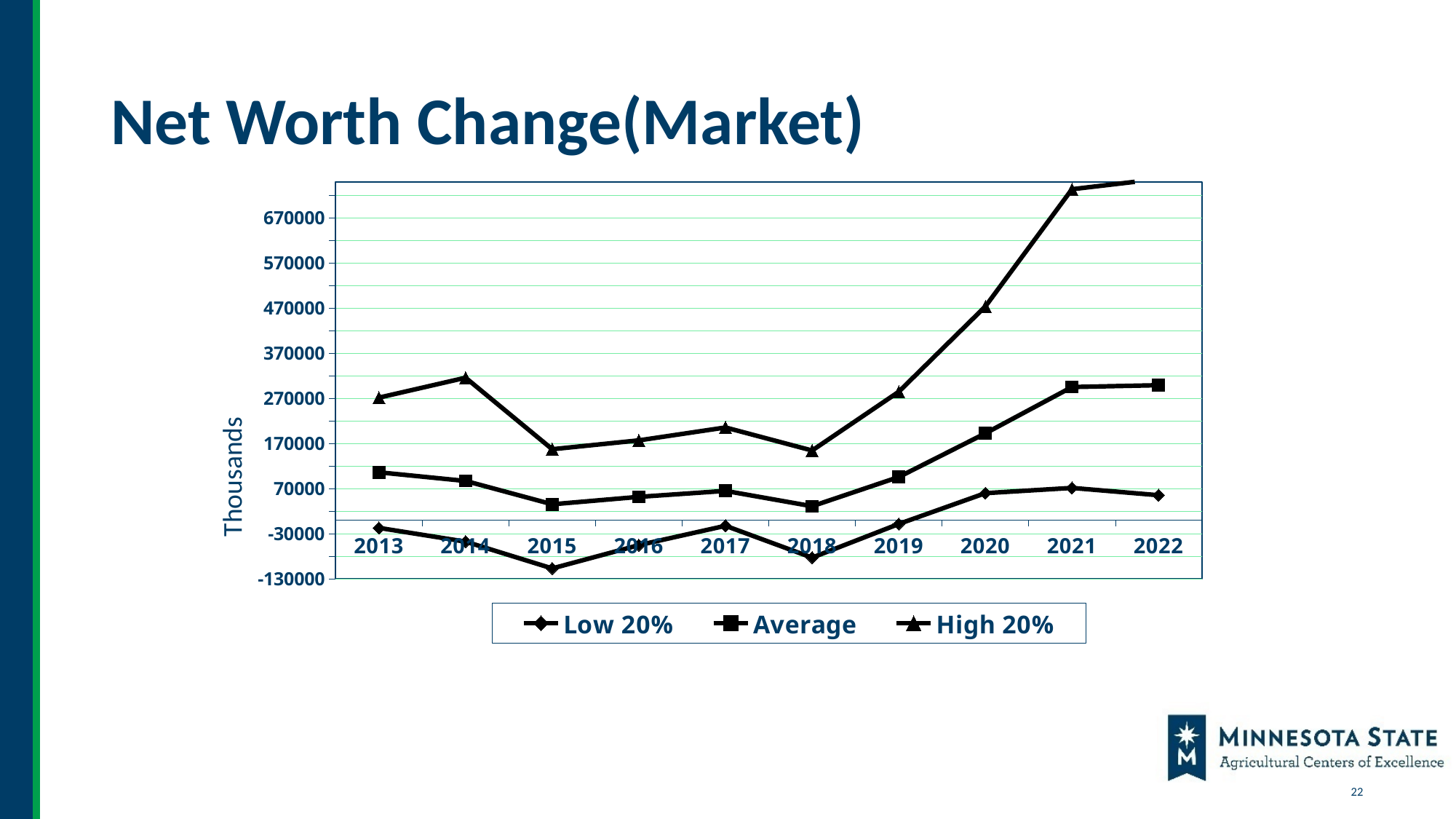
What kind of chart is shown on the slide? Line chart Which is larger for the Average series: the value in 2013 or the value in 2021? 2021 What is the label on the vertical axis? Thousands How many years are plotted along the x axis? 10 Is the value for Low 20% in 2015 greater or less than -30000? less Does the High 20% series rise or fall from 2018 to 2022? Rises Is the value for Average in 2018 greater or less than 70000? less How many series does the legend list? 3 In which year does the High 20% series reach its highest value? 2022 Is the value for High 20% in 2021 greater or less than 670000? greater In which year does the Low 20% series reach its lowest value? 2015